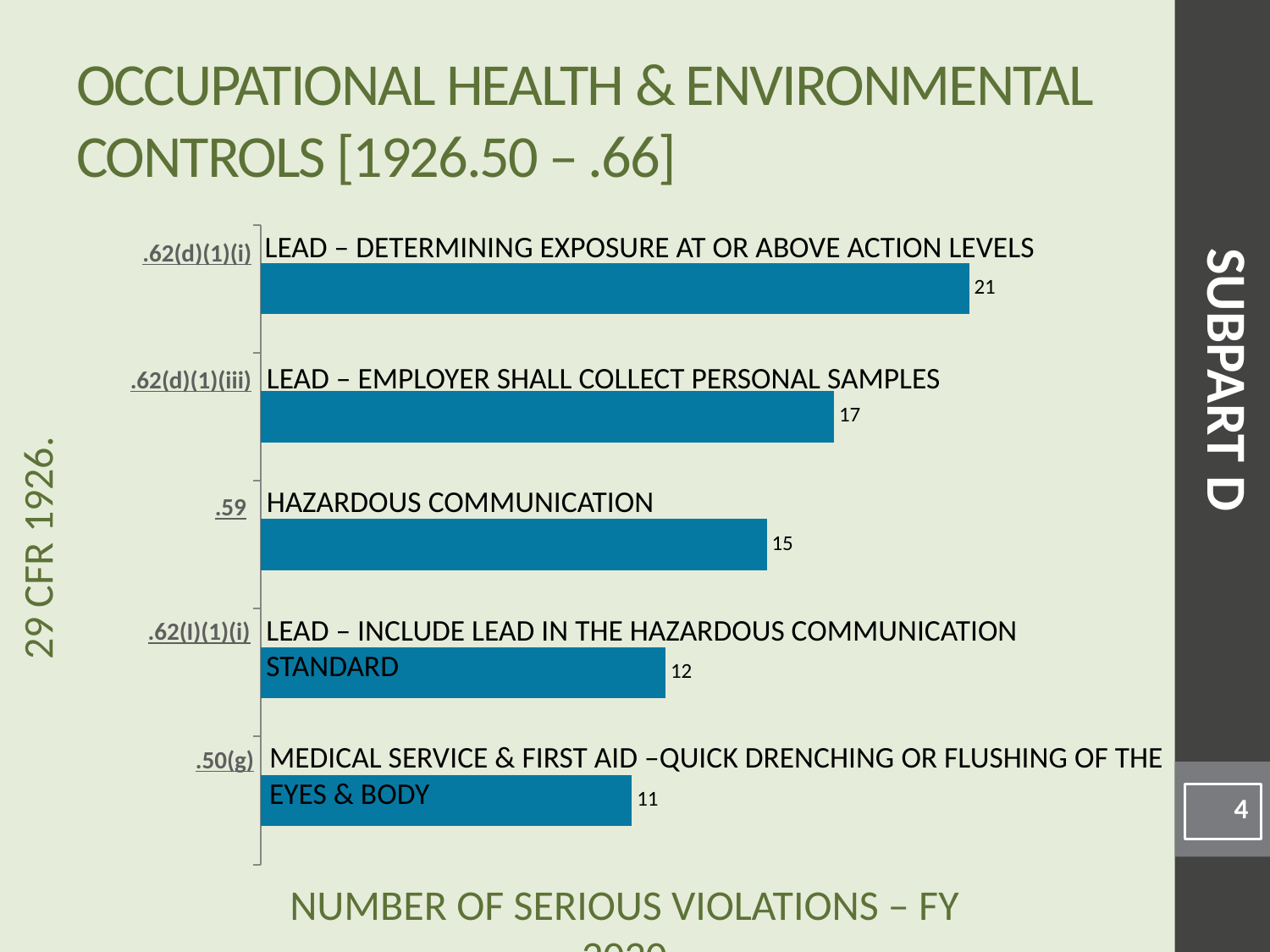
Which has more serious violations: .59 Hazardous Communication or .62(l)(1)(i) Lead – Include Lead in the Hazardous Communication Standard? .59 Hazardous Communication Which category has the highest number of serious violations? .62(d)(1)(i) Lead – Determining Exposure at or Above Action Levels What is the difference in serious violations between .62(l)(1)(i) and .50(g)? 1 How many categories (bars) does the chart show? 5 What is the number of serious violations for .62(d)(1)(i), Lead – Determining Exposure at or Above Action Levels? 21 What is the number of serious violations for .50(g), Medical Service & First Aid – Quick Drenching or Flushing of the Eyes & Body? 11 What is the difference in serious violations between .62(d)(1)(i) and .62(d)(1)(iii)? 4 What colour are the bars in the chart? blue What is the number of serious violations for .59, Hazardous Communication? 15 Which category has the lowest number of serious violations? .50(g) Medical Service & First Aid – Quick Drenching or Flushing of the Eyes & Body What is the number of serious violations for .62(l)(1)(i), Lead – Include Lead in the Hazardous Communication Standard? 12 What kind of chart is shown on the slide? bar chart